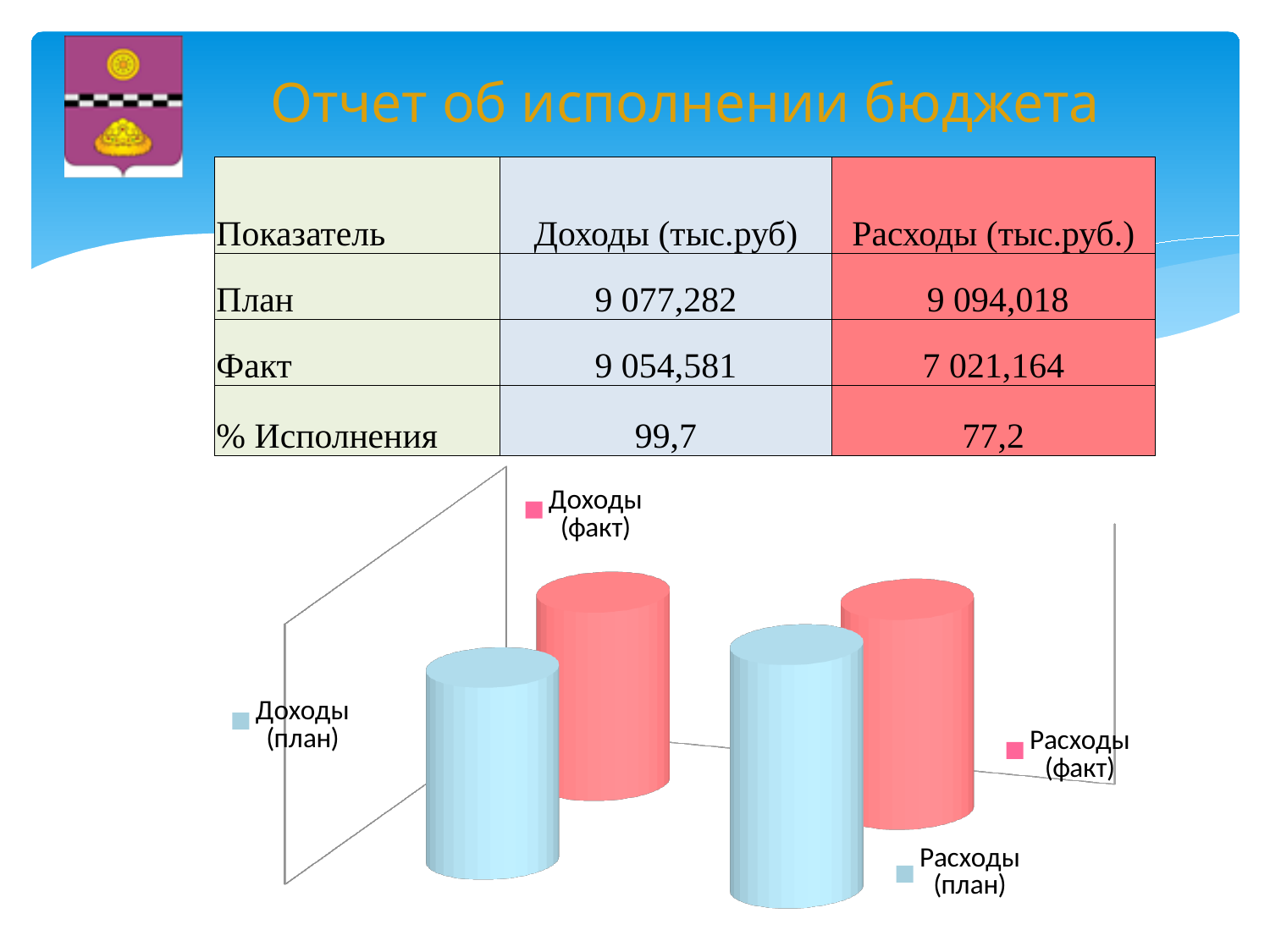
In the chart, which is larger: Расходы (план) or Расходы (факт)? Расходы (план) What colour are the Доходы (план) and Расходы (план) bars in the chart? light blue What kind of chart is shown below the table on the slide? bar chart What colour are the Доходы (факт) and Расходы (факт) bars in the chart? red How many bars (cylinders) are plotted in the chart? 4